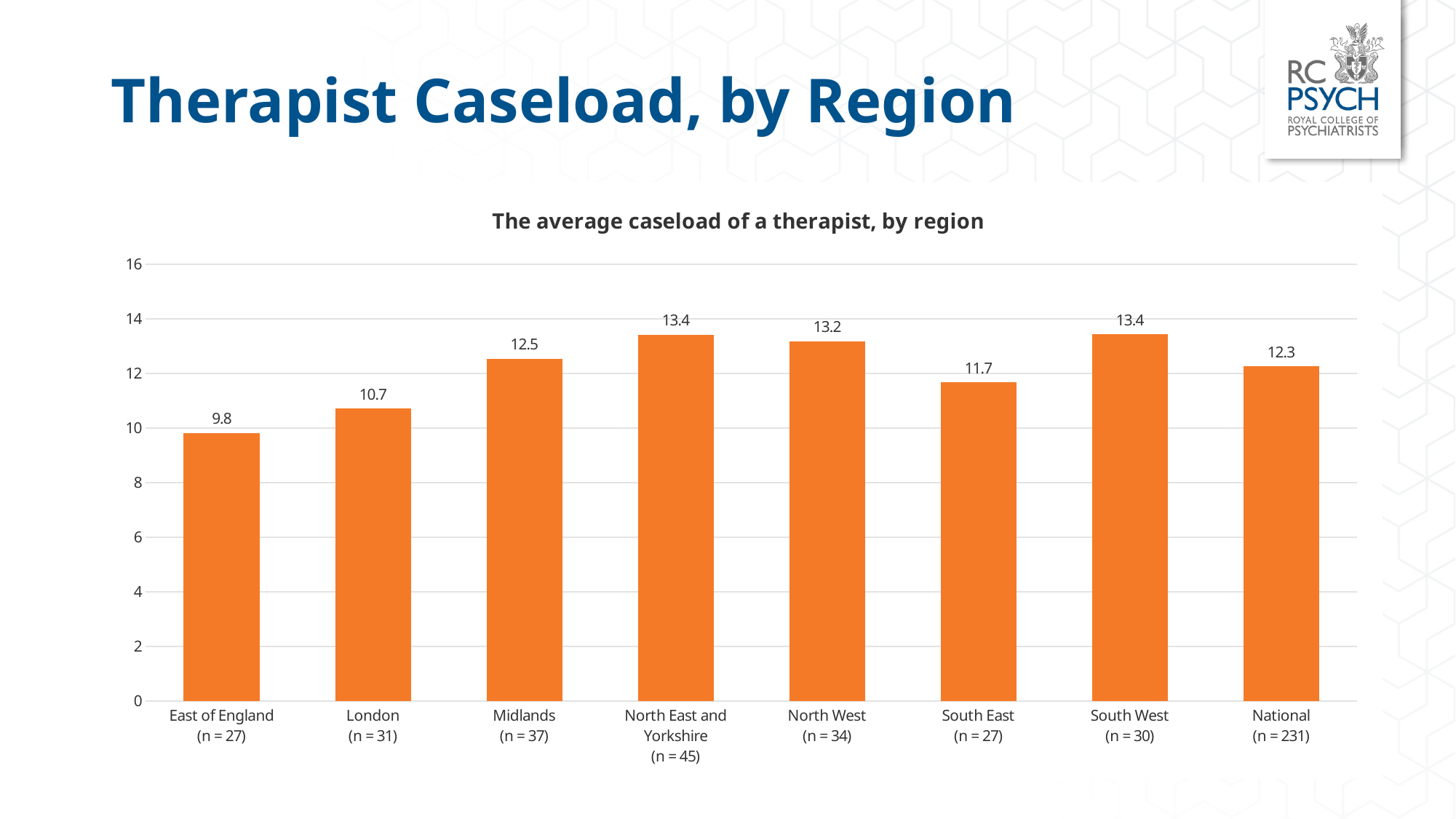
Is the average caseload for the North East and Yorkshire greater or less than 12? greater What is the difference between the average caseload in the South West and in London? 2.7 What is the average caseload of a therapist in the South East? 11.7 What is the difference between the average caseload in the North West and in the East of England? 3.4 How many bars are shown in the chart? 8 Which has a higher average caseload, the Midlands or the South East? Midlands What is the average caseload of a therapist in London? 10.7 What is the average caseload of a therapist in the Midlands? 12.5 What is the National average caseload of a therapist? 12.3 What type of chart is shown on the slide? Bar chart What is the title of the chart? The average caseload of a therapist, by region Which region has the lowest average therapist caseload? East of England